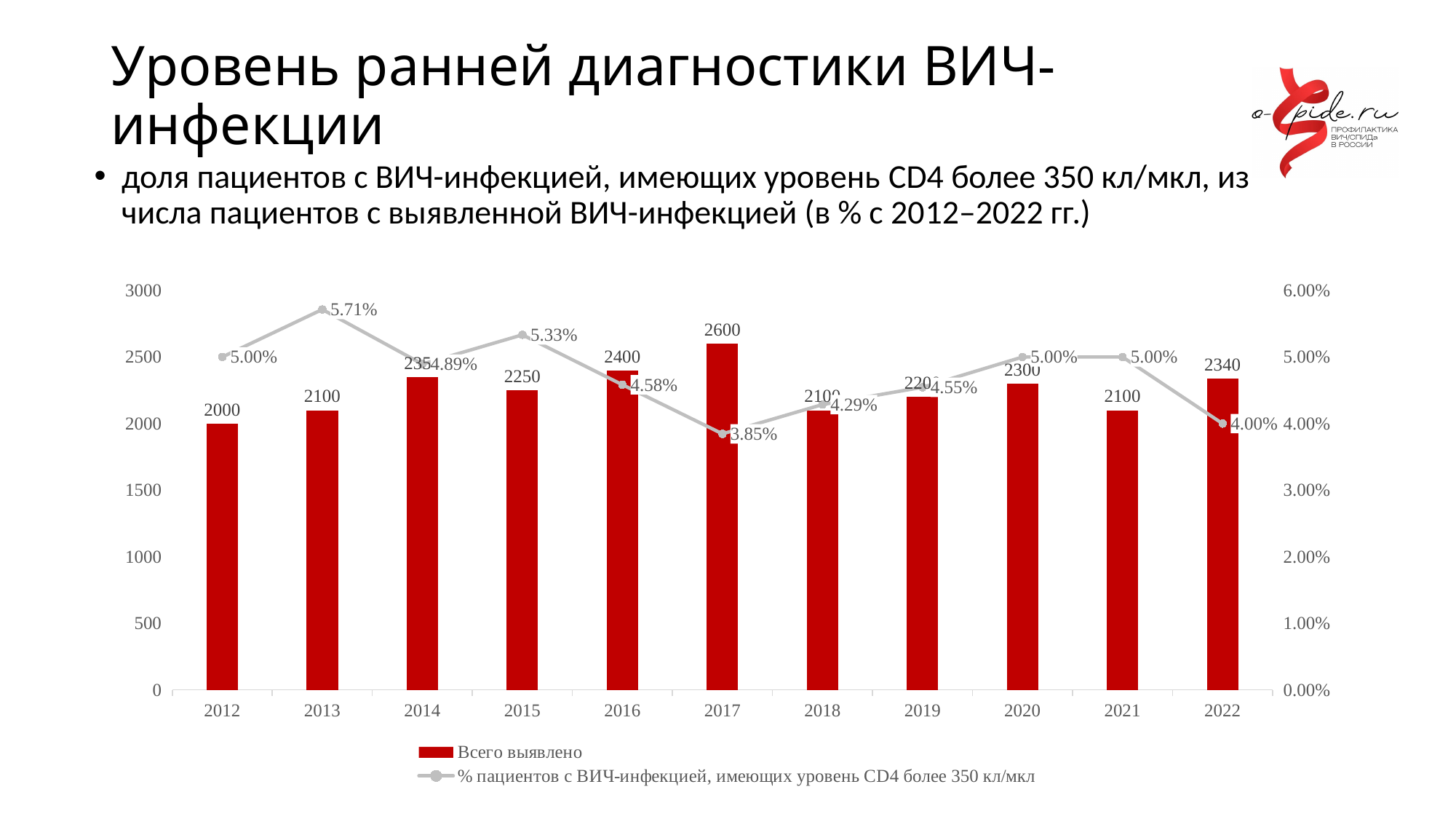
Does the percentage line rise or fall from 2021 to 2022? fall Is the value of Всего выявлено for 2022 greater or less than 2500? less How many series does the legend list? 2 Which year has the lowest percentage of patients with CD4 above 350 кл/мкл? 2017 Which year has a larger value of Всего выявлено, 2016 or 2021? 2016 What is the difference between Всего выявлено in 2017 and in 2012? 600 What is the value of Всего выявлено for 2017? 2600 Which year has the lowest value of Всего выявлено? 2012 What is the percentage value shown for 2022? 4.00% How many years are shown on the x axis of the chart? 11 What percentage of patients with CD4 above 350 кл/мкл is shown for 2013? 5.71% Which year has the highest value of Всего выявлено? 2017